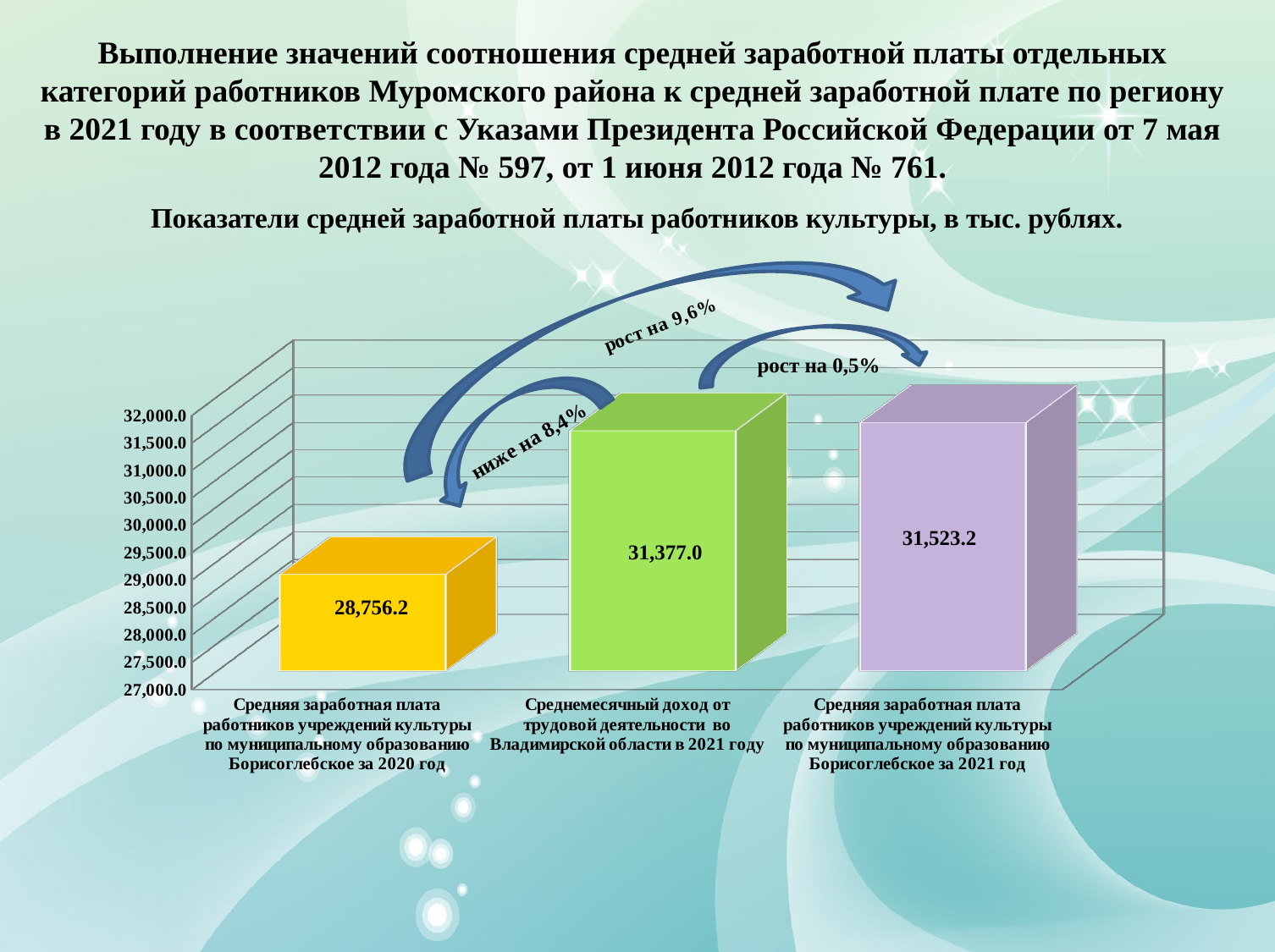
What type of chart is shown on the slide? bar chart According to the arrow annotation, by what percentage did the salary grow from 2020 to 2021 in Borisoglebskoe? 9,6% What is the average salary of cultural institution workers in Borisoglebskoe municipality for 2021? 31,523.2 What is the average salary of cultural institution workers in Borisoglebskoe municipality for 2020, in thousand rubles? 28,756.2 Which category has the lowest value on the chart? Средняя заработная плата работников учреждений культуры по муниципальному образованию Борисоглебское за 2020 год Which is larger: the Vladimir region average monthly income in 2021 or the Borisoglebskoe cultural workers' salary for 2020? Среднемесячный доход от трудовой деятельности во Владимирской области в 2021 году How many bars are shown on the chart? 3 What is the average monthly income from labour activity in Vladimir region in 2021 shown on the chart? 31,377.0 Is the value for the 2020 Borisoglebskoe cultural workers' salary greater or less than 29,000.0? less Which category has the highest value on the chart? Средняя заработная плата работников учреждений культуры по муниципальному образованию Борисоглебское за 2021 год What is the difference between the 2021 and 2020 average salaries of cultural workers in Borisoglebskoe? 2,767.0 By how much does the 2021 Borisoglebskoe cultural workers' salary exceed the Vladimir region average monthly income in 2021? 146.2